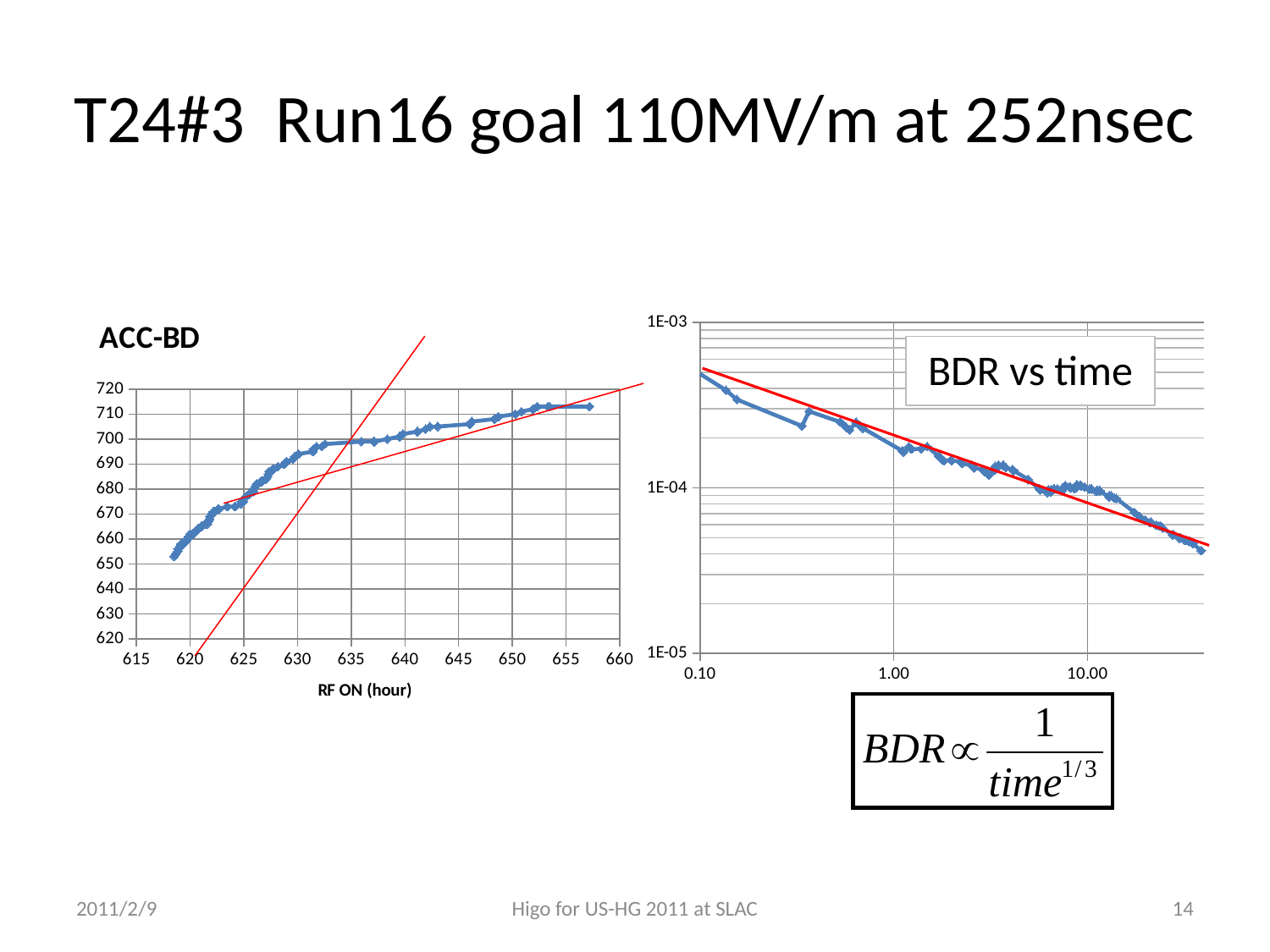
In the ACC-BD chart, do the plotted values rise or fall as RF ON (hour) increases? rise In the ACC-BD chart, is the plotted value at 640 hours greater or less than 690? greater In the ACC-BD chart, is the plotted value at 650 hours larger or smaller than the value at 620 hours? larger What is the title of the chart on the right of the slide? BDR vs time In the ACC-BD chart, is the plotted value at 650 hours greater or less than 700? greater In the BDR vs time chart, is the plotted value at 0.10 greater or less than 1E-03? less What kind of chart is the ACC-BD chart on the left? line chart In the BDR vs time chart, do the plotted values rise or fall as time increases along the x axis? fall What kind of chart is the BDR vs time chart on the right? line chart What is the x-axis label of the ACC-BD chart? RF ON (hour)